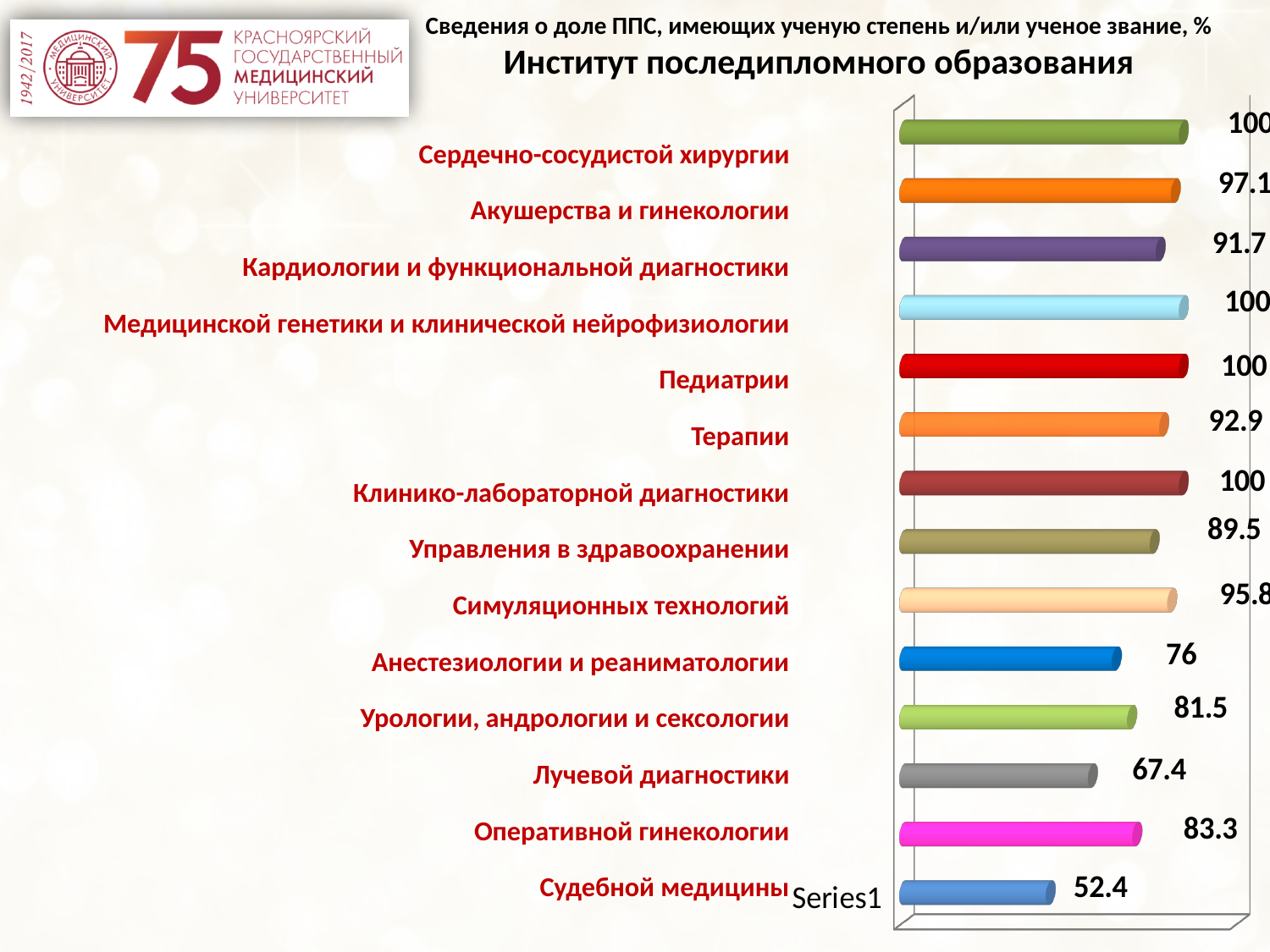
What is the value for Судебной медицины? 52.4 What is the value for Акушерства и гинекологии? 97.1 What is the highest value shown in the chart? 100 Which category has the lowest value? Судебной медицины What is the value for Терапии? 92.9 What is the value for Лучевой диагностики? 67.4 How many categories are shown in the chart? 14 What type of chart is shown on the slide? Bar chart What is the difference between the values for Кардиологии и функциональной диагностики and Управления в здравоохранении? 2.2 Which is larger: the value for Урологии, андрологии и сексологии or for Оперативной гинекологии? Оперативной гинекологии What is the difference between the values for Анестезиологии и реаниматологии and Судебной медицины? 23.6